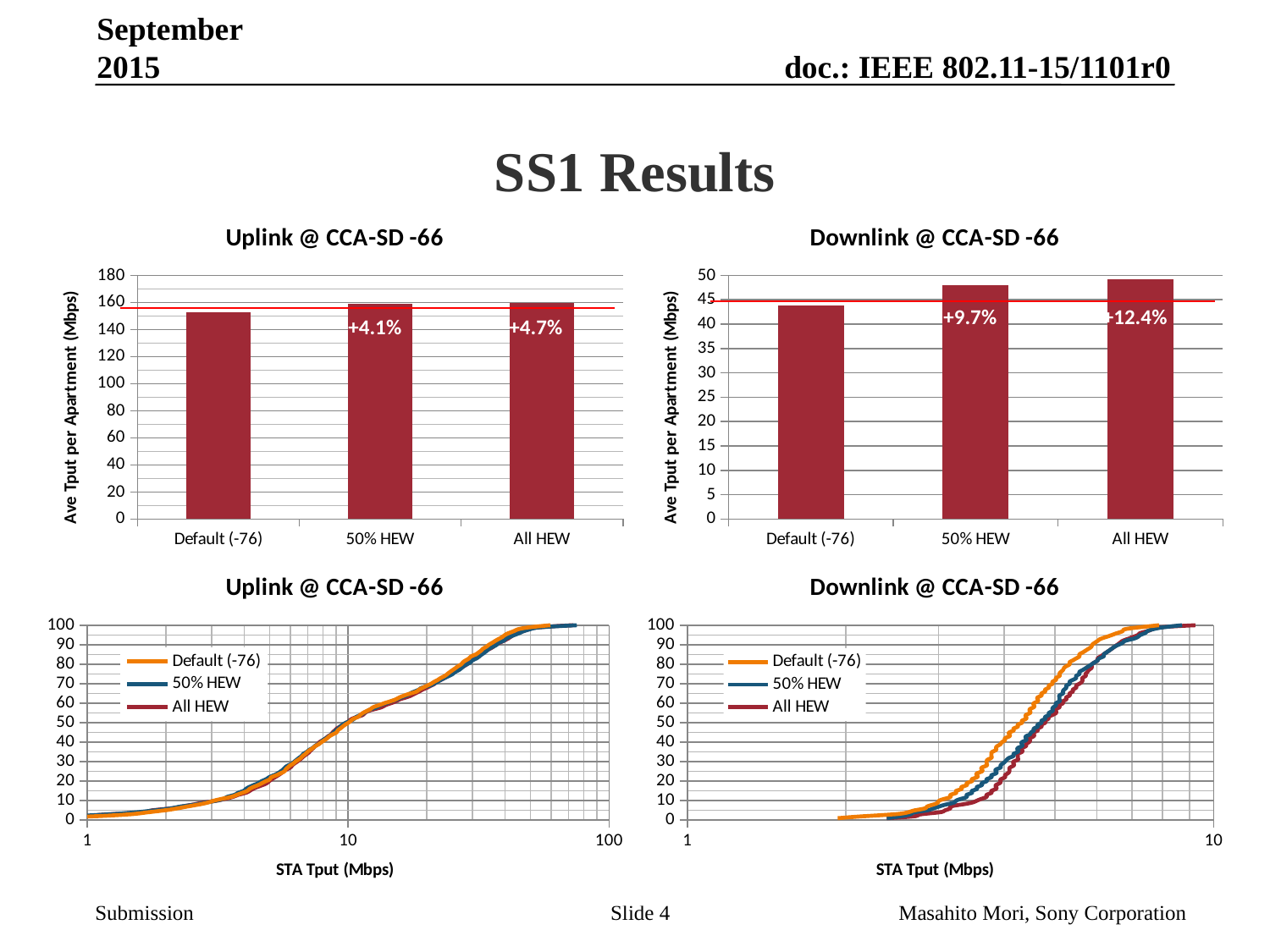
In the top-right bar chart titled 'Downlink @ CCA-SD -66', what percentage label is shown on the 50% HEW bar? +9.7% In the top-right bar chart titled 'Downlink @ CCA-SD -66', is the value for Default (-76) greater or less than 45? less How many series does the legend list in the bottom-right chart titled 'Downlink @ CCA-SD -66'? 3 In the top-right bar chart titled 'Downlink @ CCA-SD -66', is the value for All HEW greater or less than 45? greater In the top-left bar chart titled 'Uplink @ CCA-SD -66', which category has the lowest average throughput per apartment? Default (-76) How many categories are shown on the x axis of the top-left bar chart titled 'Uplink @ CCA-SD -66'? 3 In the top-left bar chart titled 'Uplink @ CCA-SD -66', what percentage label is shown on the 50% HEW bar? +4.1% In the top-right bar chart titled 'Downlink @ CCA-SD -66', what percentage label is shown on the All HEW bar? +12.4% In the top-right bar chart titled 'Downlink @ CCA-SD -66', which category has the lowest average throughput per apartment? Default (-76) In the top-left bar chart titled 'Uplink @ CCA-SD -66', what percentage label is shown on the All HEW bar? +4.7% What kind of chart is the bottom-left chart titled 'Uplink @ CCA-SD -66'? line chart In the top-left bar chart titled 'Uplink @ CCA-SD -66', is the value for Default (-76) greater or less than 160? less